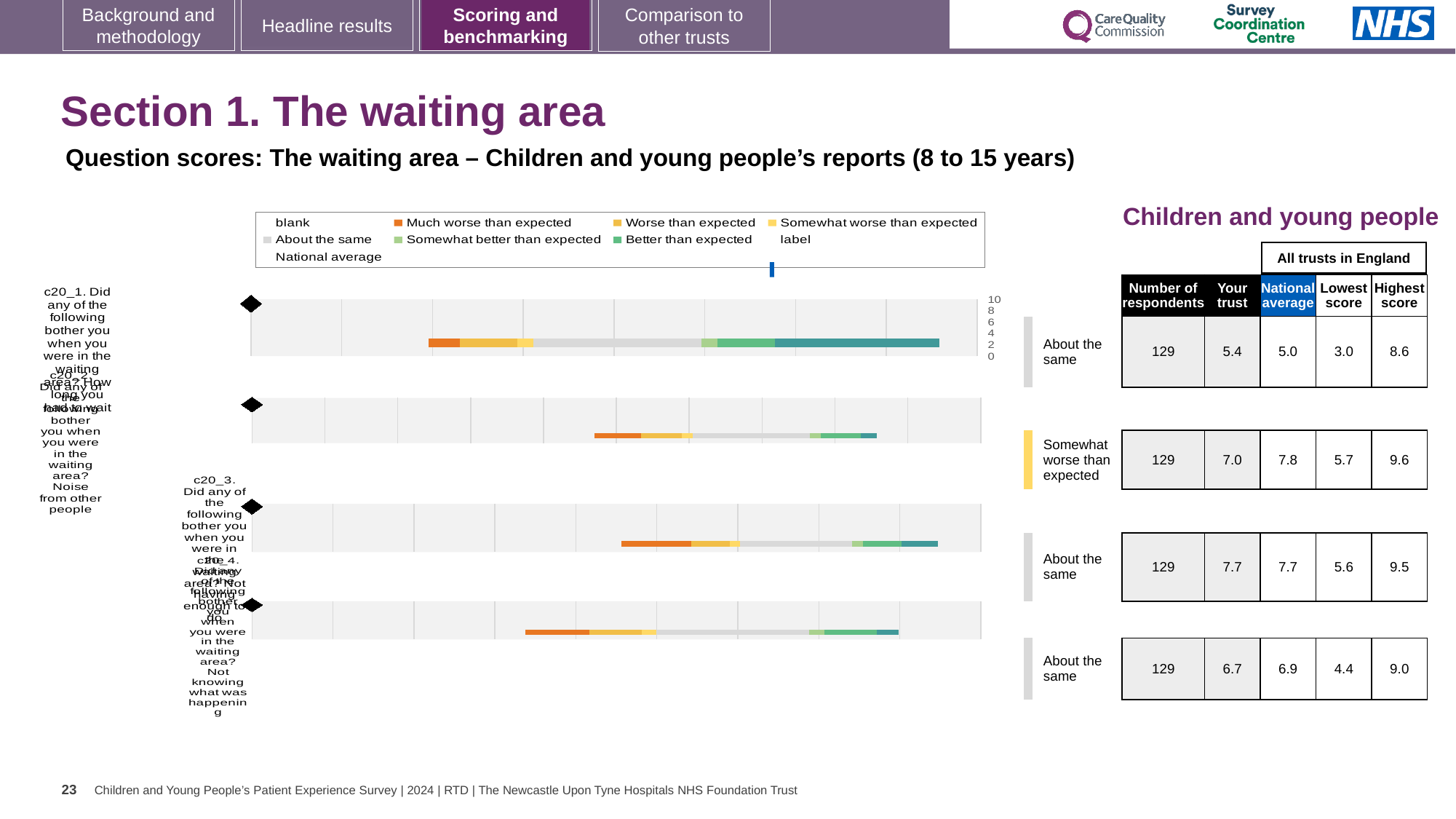
What kind of chart is used to show the question scores on this slide? bar chart In the table next to the charts, is the 'Your trust' score for the second question (c20_2) larger or smaller than its National average? smaller In the table next to the charts, what is the Lowest score for the fourth question (c20_4)? 4.4 Which legend entry is shown in orange? Much worse than expected How many entries does the chart legend list? 9 Which legend entry is shown in dark teal? Better than expected In the table next to the charts, which question has the highest 'Your trust' score? c20_3 In the table next to the charts, what is the difference between the Highest score and the Lowest score for the first question (c20_1)? 5.6 In the table next to the charts, what is the National average for the second question (c20_2)? 7.8 How many separate bar charts (one per question) are shown on the slide? 4 In the table next to the charts, what is the 'Your trust' score for the first question (c20_1)? 5.4 In the table next to the charts, what is the Highest score for the third question (c20_3)? 9.5